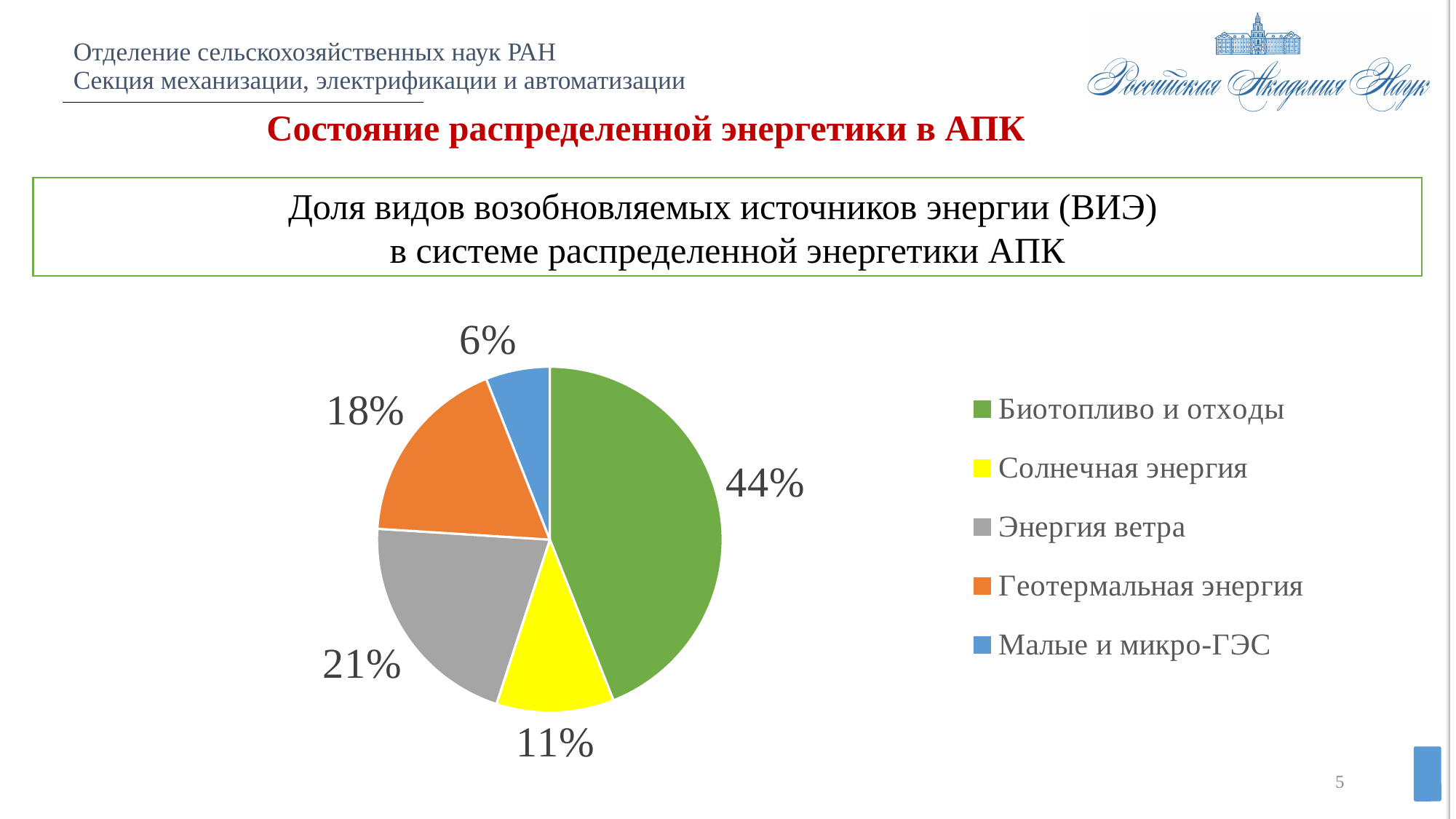
What type of chart is shown on the slide? Pie chart How many categories does the legend list? 5 What share of the pie does Геотермальная энергия have? 18% What share of the pie does Солнечная энергия have? 11% Which is larger: the share of Энергия ветра or the share of Геотермальная энергия? Энергия ветра What share of the pie does Малые и микро-ГЭС have? 6% What colour is the slice for Солнечная энергия? Yellow Which category has the smallest share of the pie? Малые и микро-ГЭС Which category has the largest share of the pie? Биотопливо и отходы What is the difference in percentage points between Биотопливо и отходы and Энергия ветра? 23